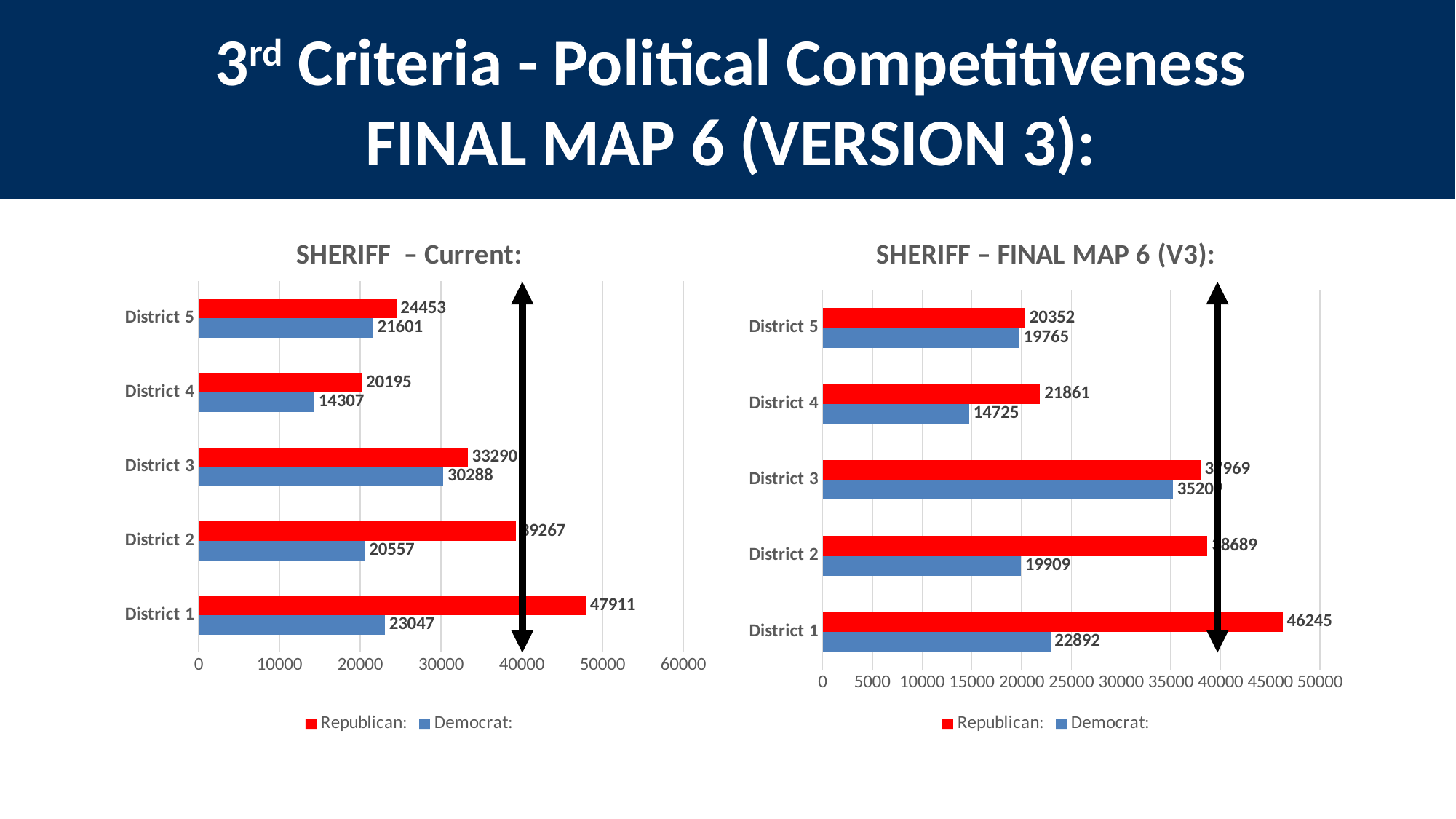
In the SHERIFF – Current chart, what is the difference between the Republican and Democrat values for District 1? 24864 In the SHERIFF – FINAL MAP 6 (V3) chart, what is the Democrat value for District 5? 19765 How many series does the legend of the SHERIFF – Current chart list? 2 How many districts are shown in the SHERIFF – FINAL MAP 6 (V3) chart? 5 In the SHERIFF – FINAL MAP 6 (V3) chart, which district has the lowest Democrat value? District 4 What type of chart is the SHERIFF – Current chart? Bar chart In the SHERIFF – Current chart, what is the Democrat value for District 4? 14307 In the SHERIFF – Current chart, what is the Republican value for District 1? 47911 In the SHERIFF – FINAL MAP 6 (V3) chart, what is the difference between the Republican and Democrat values for District 5? 587 In the SHERIFF – Current chart, which district has the highest Republican value? District 1 In the SHERIFF – Current chart, which is larger for District 3: the Republican value or the Democrat value? Republican In the SHERIFF – FINAL MAP 6 (V3) chart, what is the Republican value for District 4? 21861